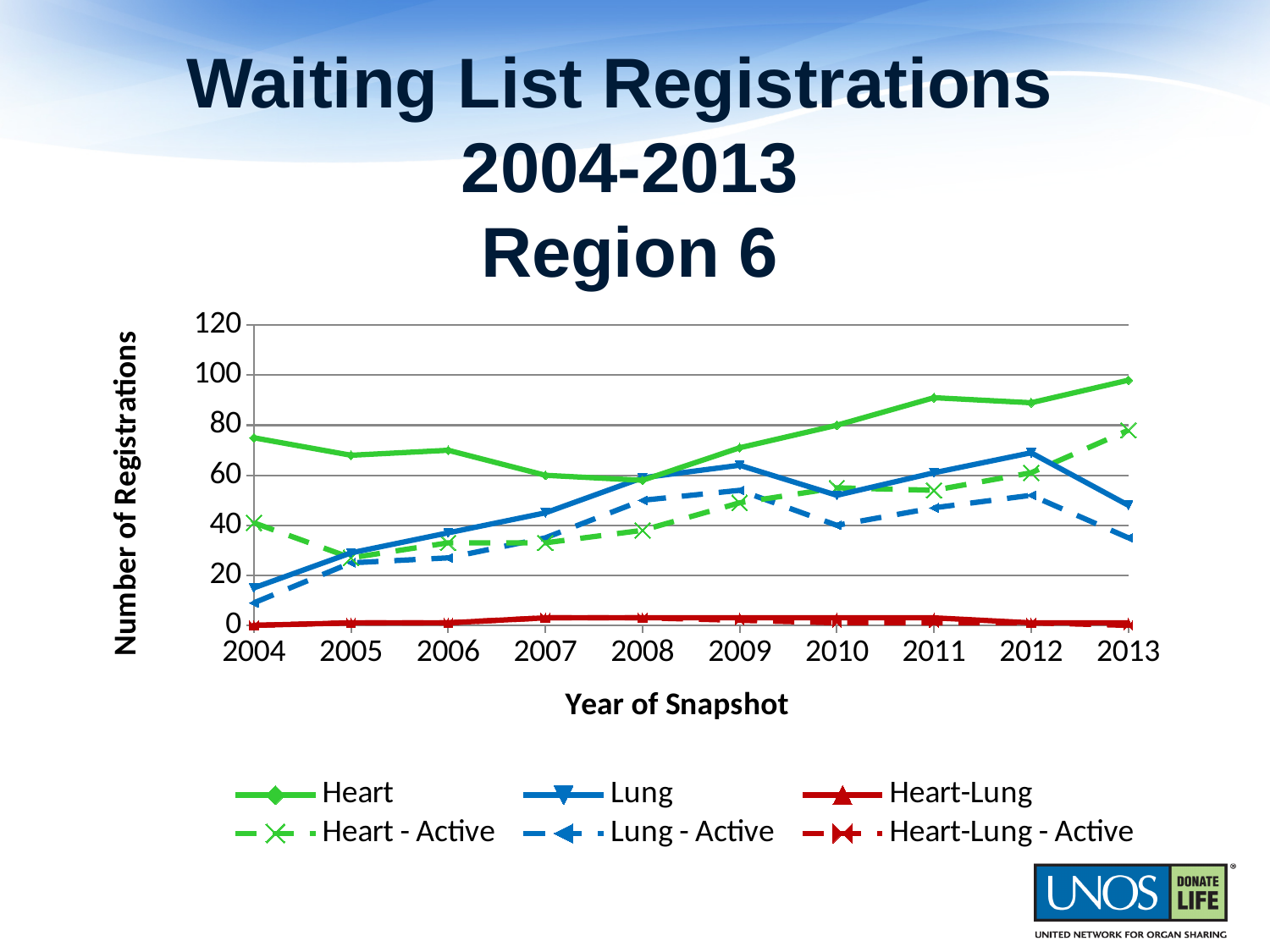
In which year is the Heart series at its highest? 2013 Which series has the larger value in 2004, Lung or Heart - Active? Heart - Active What is the title of the x axis? Year of Snapshot What kind of chart is shown on the slide? line chart In which year is the Lung series at its lowest? 2004 Is the value for Lung in 2004 greater or less than 20? less How many series does the legend list? 6 Which series has the larger value in 2013, Heart or Lung? Heart Does the Heart series rise or fall from 2008 to 2013? rise Is the value for Lung - Active in 2013 greater or less than 40? less How many years are shown on the x axis? 10 Is the value for Heart in 2013 greater or less than 80? greater